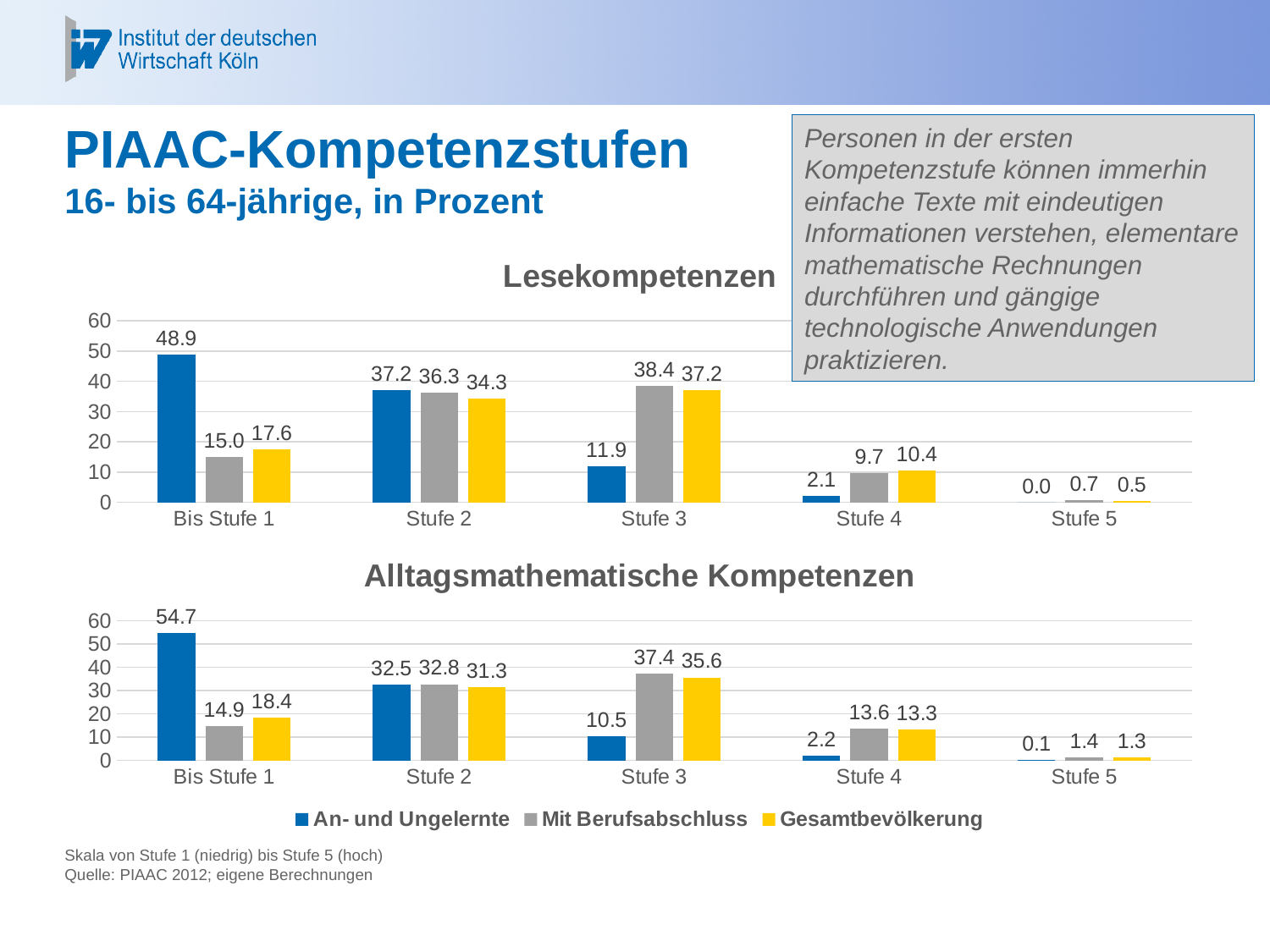
In the Lesekompetenzen chart, which category has the lowest value for Gesamtbevölkerung? Stufe 5 In the Lesekompetenzen chart, what is the value for An- und Ungelernte at Bis Stufe 1? 48.9 In the Alltagsmathematische Kompetenzen chart, which is larger at Stufe 3: Mit Berufsabschluss or An- und Ungelernte? Mit Berufsabschluss How many series does the legend list? 3 Which series is shown in yellow in the legend? Gesamtbevölkerung In the Alltagsmathematische Kompetenzen chart, is the value for An- und Ungelernte at Bis Stufe 1 greater or less than 50? greater In the Alltagsmathematische Kompetenzen chart, which category has the highest value for An- und Ungelernte? Bis Stufe 1 In the Lesekompetenzen chart, what is the difference between An- und Ungelernte and Mit Berufsabschluss at Bis Stufe 1? 33.9 What kind of chart is the Alltagsmathematische Kompetenzen chart? Bar chart How many categories are shown on the x axis of the Lesekompetenzen chart? 5 In the Alltagsmathematische Kompetenzen chart, what is the value for Gesamtbevölkerung at Stufe 3? 35.6 In the Lesekompetenzen chart, what is the value for Mit Berufsabschluss at Stufe 4? 9.7